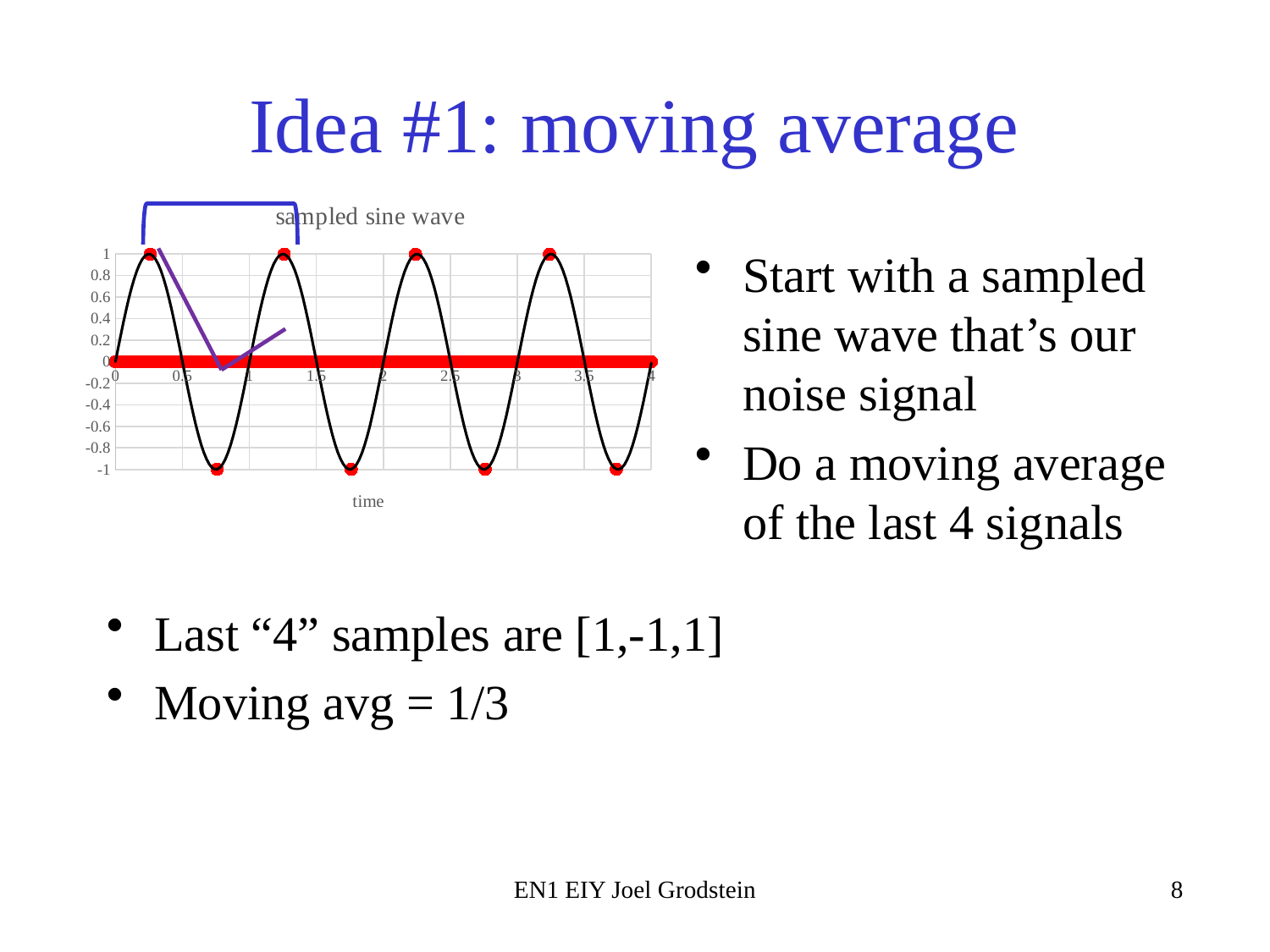
How many troughs of the sine wave reach the value -1 on the chart? 4 What is the title of the chart? sampled sine wave What is the lowest value the sine wave reaches on the chart? -1 What is the highest value the sine wave reaches on the chart? 1 What is the label of the x axis of the chart? time Is the value of the sine wave at time 0.25 greater or less than 0.5? greater What kind of chart is shown on the slide? line chart Is the value of the sine wave at time 1.25 greater or less than 0? greater What is the largest tick value shown on the x axis (time)? 4 Which is larger, the value of the sine wave at time 2.25 or at time 2.75? time 2.25 How many peaks of the sine wave reach the value 1 on the chart? 4 Is the value of the sine wave at time 0.75 greater or less than -0.5? less